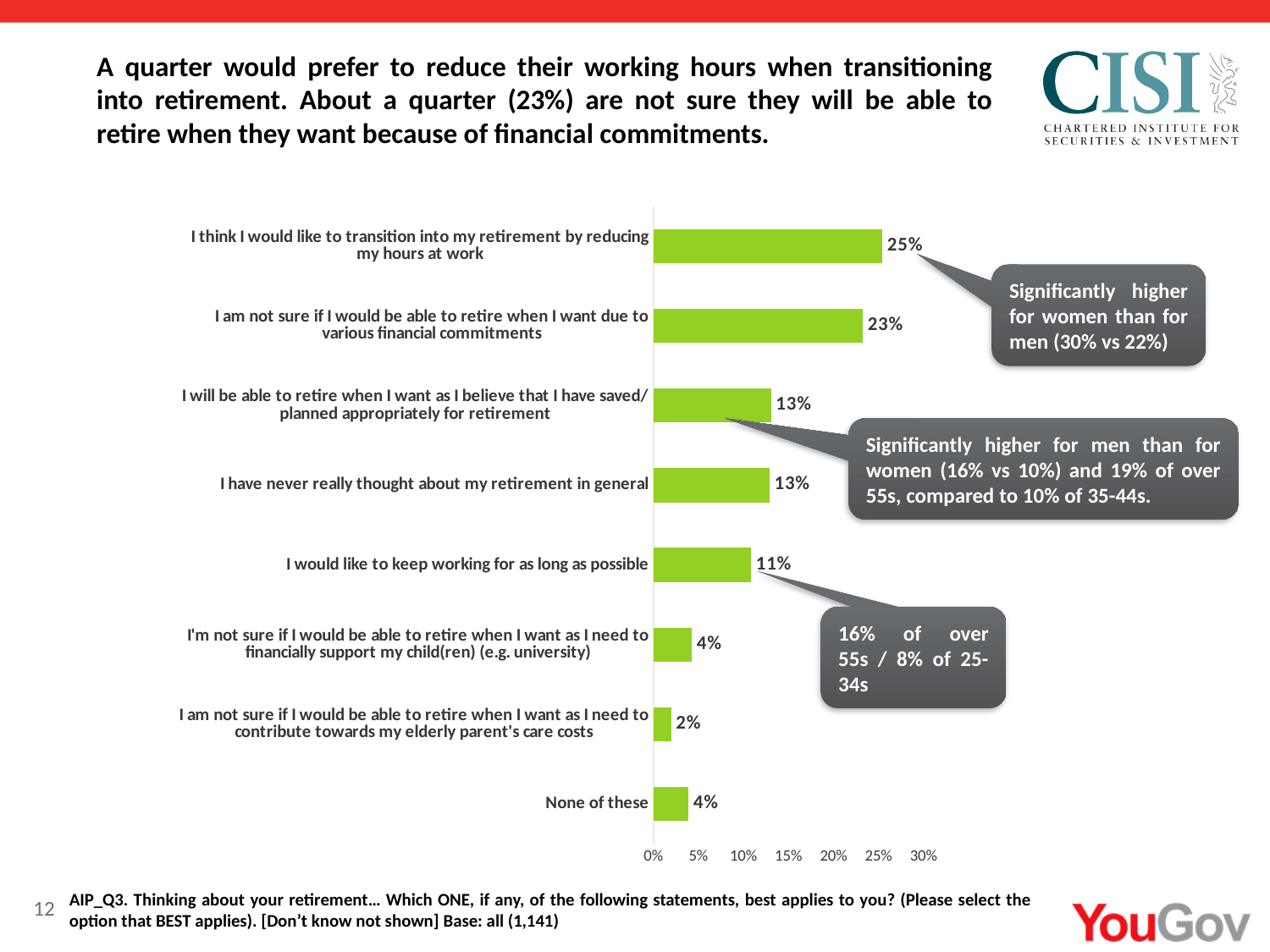
Which is larger: the percentage for 'I have never really thought about my retirement in general' or the percentage for 'None of these'? I have never really thought about my retirement in general Which statement has the lowest percentage of respondents? I am not sure if I would be able to retire when I want as I need to contribute towards my elderly parent's care costs What percentage of respondents are not sure they can retire when they want because they need to contribute towards their elderly parent's care costs? 2% What percentage of respondents said they would like to transition into retirement by reducing their hours at work? 25% Which statement has the highest percentage of respondents? I think I would like to transition into my retirement by reducing my hours at work What type of chart is shown on the slide? Bar chart What percentage of respondents are not sure if they would be able to retire when they want due to various financial commitments? 23% What is the difference in percentage points between 'I think I would like to transition into my retirement by reducing my hours at work' and 'I would like to keep working for as long as possible'? 14 percentage points What is the highest value shown on the chart's percentage axis? 30% What percentage of respondents said they would like to keep working for as long as possible? 11% How many statements (categories) are shown in the chart? 8 Is the value for 'I am not sure if I would be able to retire when I want due to various financial commitments' greater or less than 20%? greater